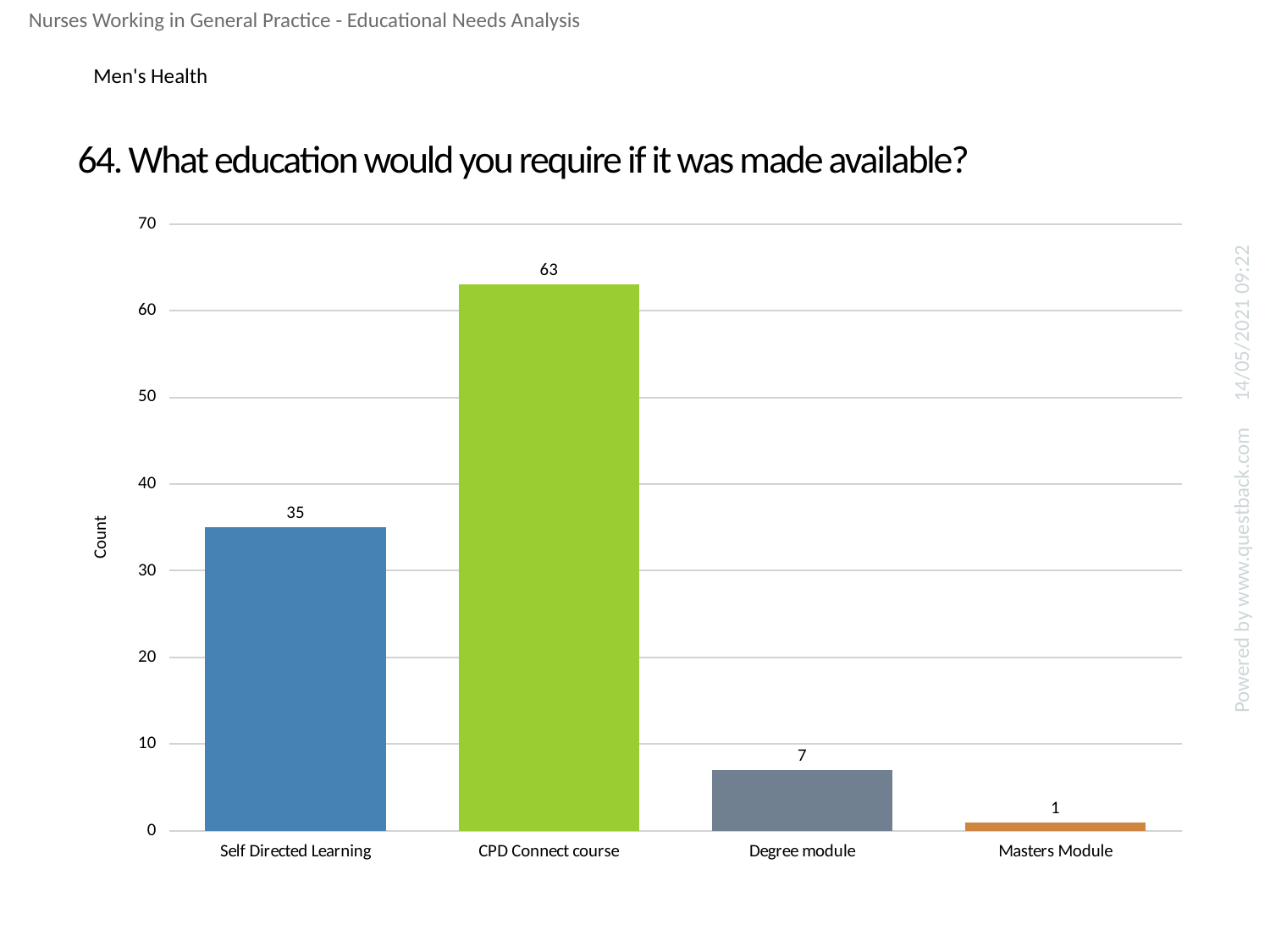
Which category has the lowest count? Masters Module What is the label of the y axis? Count What is the count for Self Directed Learning? 35 What kind of chart is shown on the slide? bar chart What is the count for Masters Module? 1 What is the difference between the counts for CPD Connect course and Self Directed Learning? 28 What is the count for CPD Connect course? 63 What is the count for Degree module? 7 Is the value for Self Directed Learning greater or less than 40? less Which has a larger count, Degree module or Masters Module? Degree module Which category has the highest count? CPD Connect course How many categories are shown on the x axis? 4